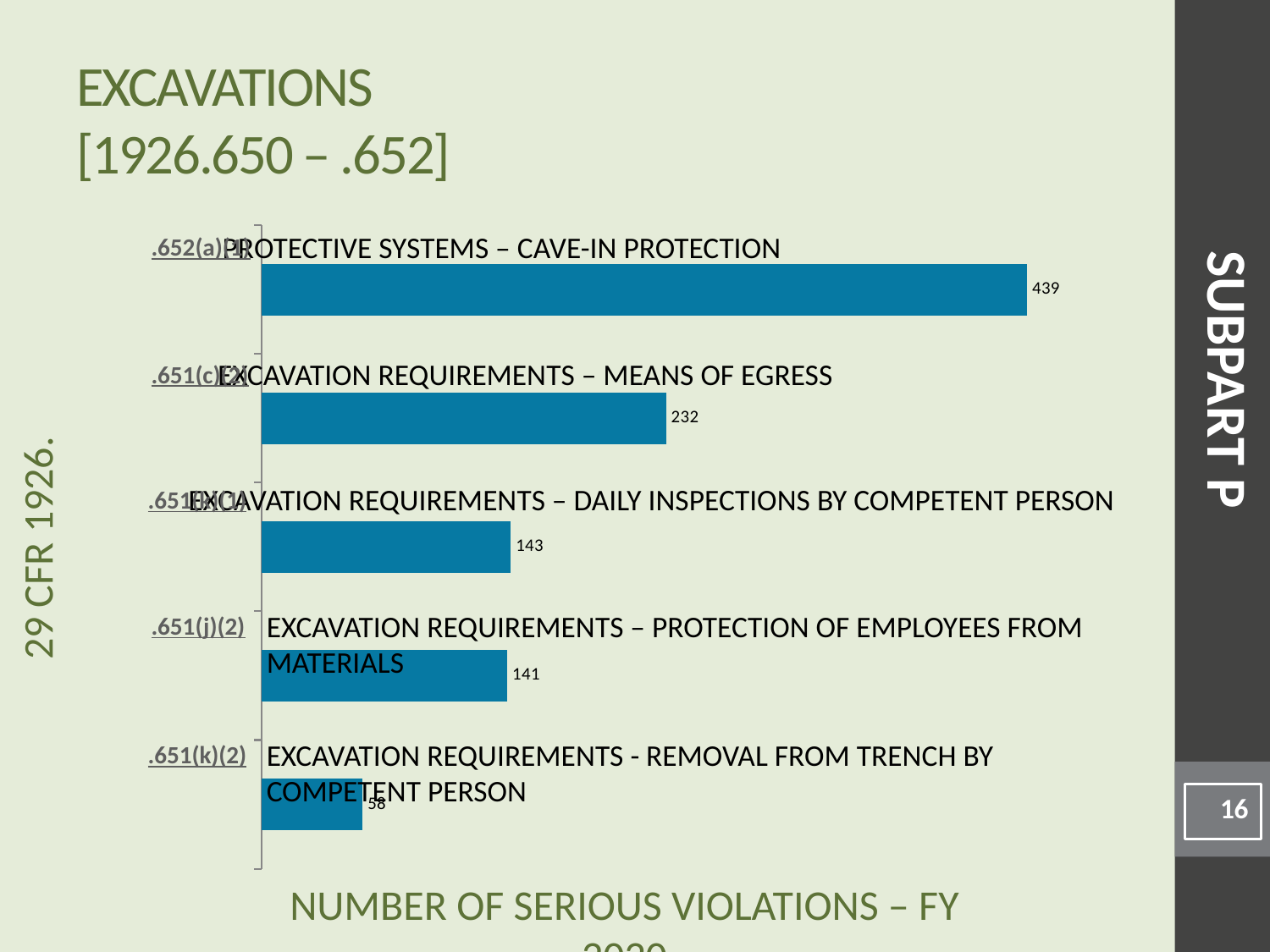
What is the number of serious violations for Excavation Requirements – Protection of Employees from Materials? 141 What is the number of serious violations for Excavation Requirements – Removal from Trench by Competent Person? 58 What is the difference between the violations for Daily Inspections by Competent Person and Protection of Employees from Materials? 2 Which category has the lowest number of serious violations? Excavation Requirements – Removal from Trench by Competent Person What is the number of serious violations for Protective Systems – Cave-In Protection? 439 Which category has the highest number of serious violations? Protective Systems – Cave-In Protection What is the number of serious violations for Excavation Requirements – Means of Egress? 232 Which has more serious violations: Means of Egress or Removal from Trench by Competent Person? Means of Egress How many categories (bars) does the chart show? 5 What is the number of serious violations for Excavation Requirements – Daily Inspections by Competent Person? 143 What is the difference between the violations for Protective Systems – Cave-In Protection and Excavation Requirements – Means of Egress? 207 What type of chart is shown on the slide? bar chart